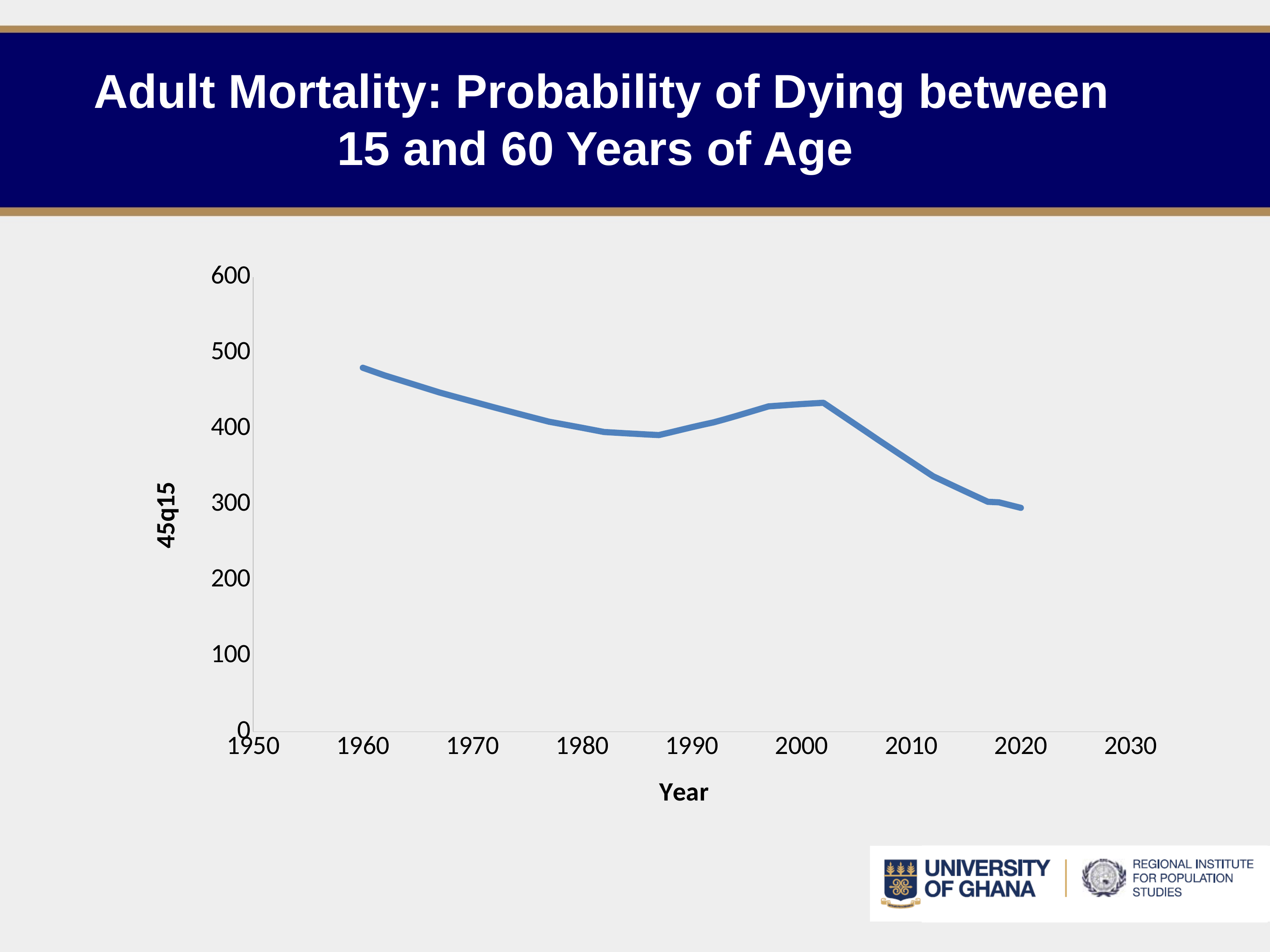
What is the label of the y axis? 45q15 Is the value for 2010 greater or less than 400? less Does the line rise or fall between 1990 and 2000? rise In which year shown is the value highest? 1960 What kind of chart is shown on the slide? line chart Which is larger, the value for 2000 or the value for 2010? 2000 Is the value for 1980 greater or less than 500? less Is the value for 1960 greater or less than 400? greater Overall, does the value rise or fall from 1960 to 2020? fall Which is larger, the value for 1960 or the value for 2020? 1960 What is the title of the chart on the slide? Adult Mortality: Probability of Dying between 15 and 60 Years of Age